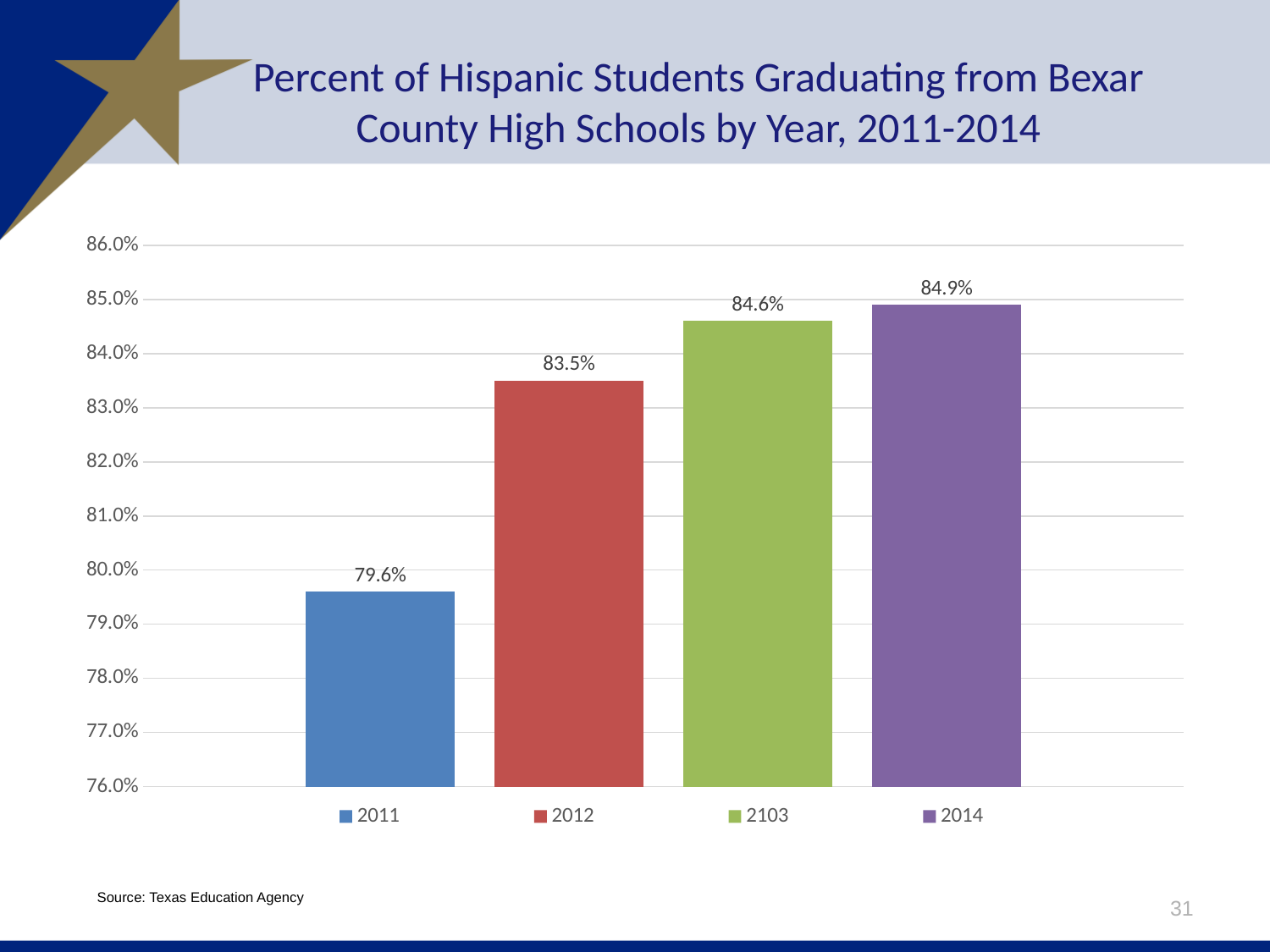
How many bars are shown in the chart? 4 What is the graduation percentage for 2012? 83.5% What is the graduation percentage for the series labelled 2103 in the legend? 84.6% What is the difference in graduation percentage between 2014 and 2011? 5.3% What is the graduation percentage for 2014? 84.9% Which year has the lowest graduation percentage? 2011 Which year has the highest graduation percentage? 2014 Which is larger, the value for 2011 or the value for 2012? 2012 What is the difference in graduation percentage between 2012 and 2011? 3.9% What kind of chart is shown on the slide? Bar chart What is the graduation percentage for 2011? 79.6% Do the graduation percentages rise or fall from 2011 to 2014? Rise